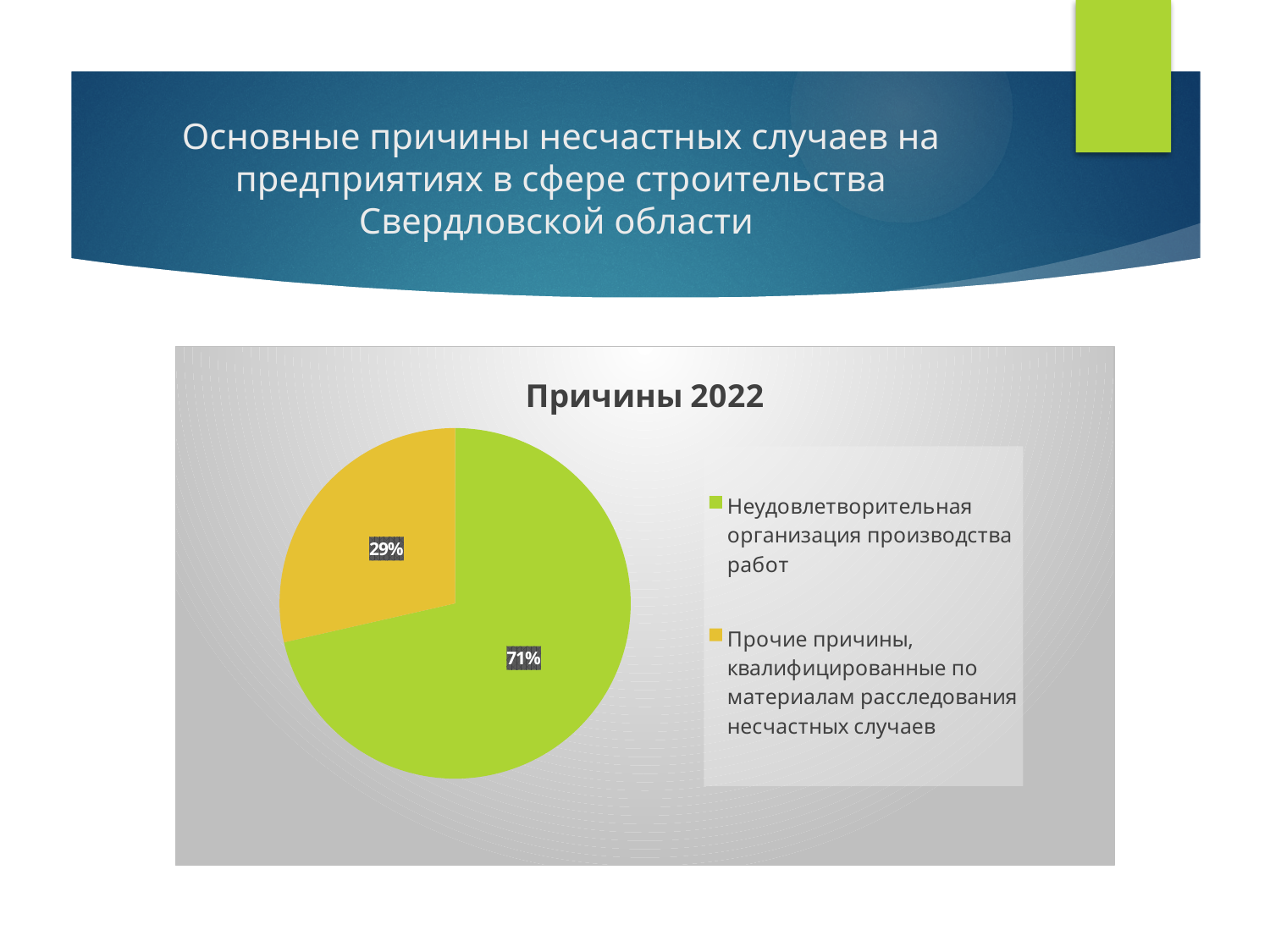
What colour is the slice for "Прочие причины, квалифицированные по материалам расследования несчастных случаев"? yellow Which is larger: the slice for "Неудовлетворительная организация производства работ" or the slice for "Прочие причины"? Неудовлетворительная организация производства работ How many categories does the pie chart show? 2 How many entries does the legend list? 2 Which category has the largest slice of the pie? Неудовлетворительная организация производства работ What share of the pie does "Прочие причины, квалифицированные по материалам расследования несчастных случаев" take? 29% What share of the pie does "Неудовлетворительная организация производства работ" take? 71% What is the difference in percentage points between the two slices of the pie? 42 What type of chart is shown on the slide? pie chart What is the title of the chart? Причины 2022 Which category has the smallest slice of the pie? Прочие причины, квалифицированные по материалам расследования несчастных случаев